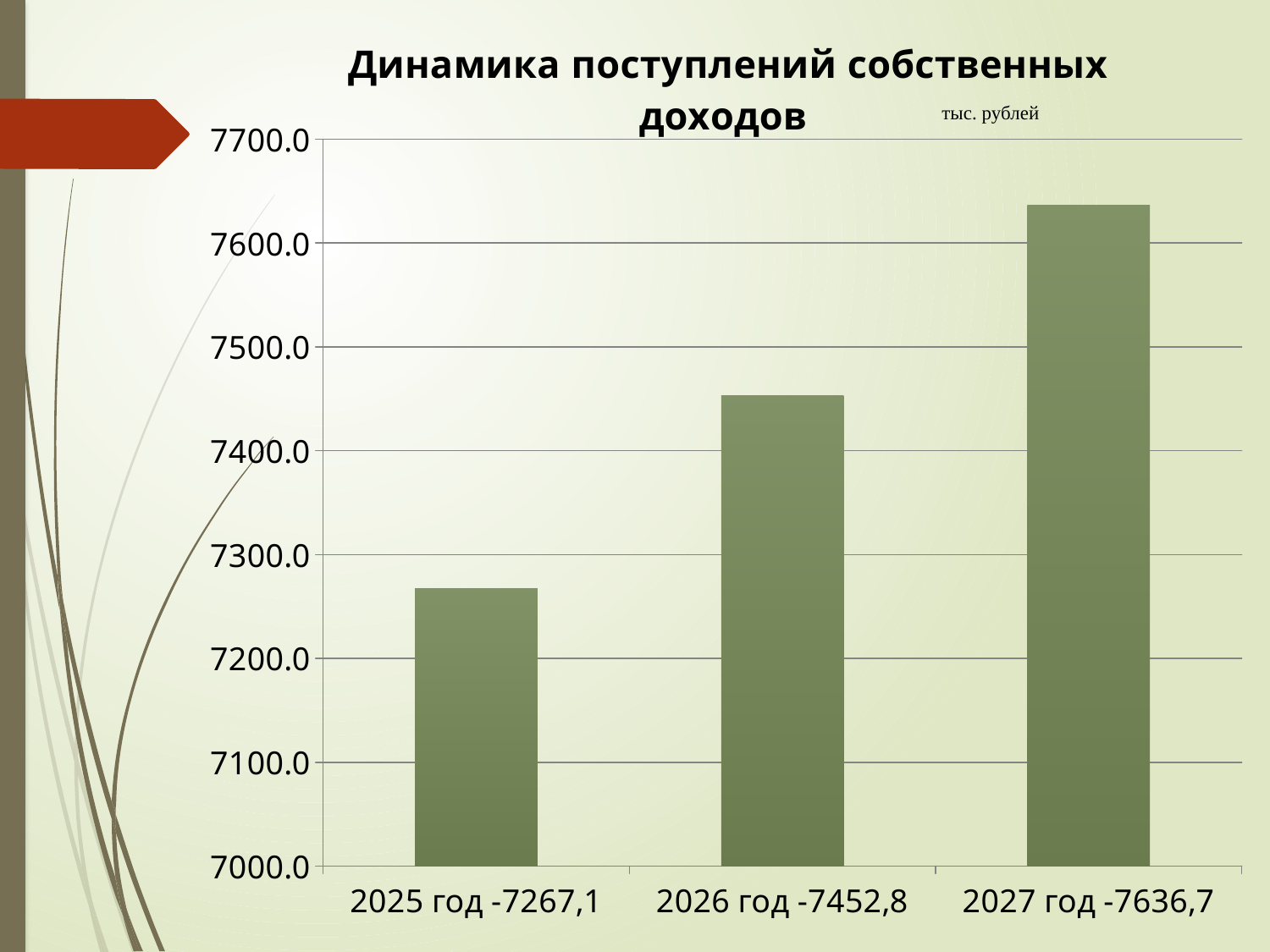
Which year has the highest value of own revenues? 2027 год What is the value of own revenues for 2026 год? 7452,8 What is the value of own revenues for 2025 год? 7267,1 Is the value for 2026 год greater or less than 7400.0? greater In what units are the values on the chart given? тыс. рублей How many bars (years) are shown on the chart? 3 What type of chart is shown on the slide? bar chart What is the title of the chart? Динамика поступлений собственных доходов What is the difference between the values for 2027 год and 2025 год? 369,6 Do the values rise or fall from 2025 год to 2027 год? rise Which year has the lowest value of own revenues? 2025 год What is the value of own revenues for 2027 год? 7636,7